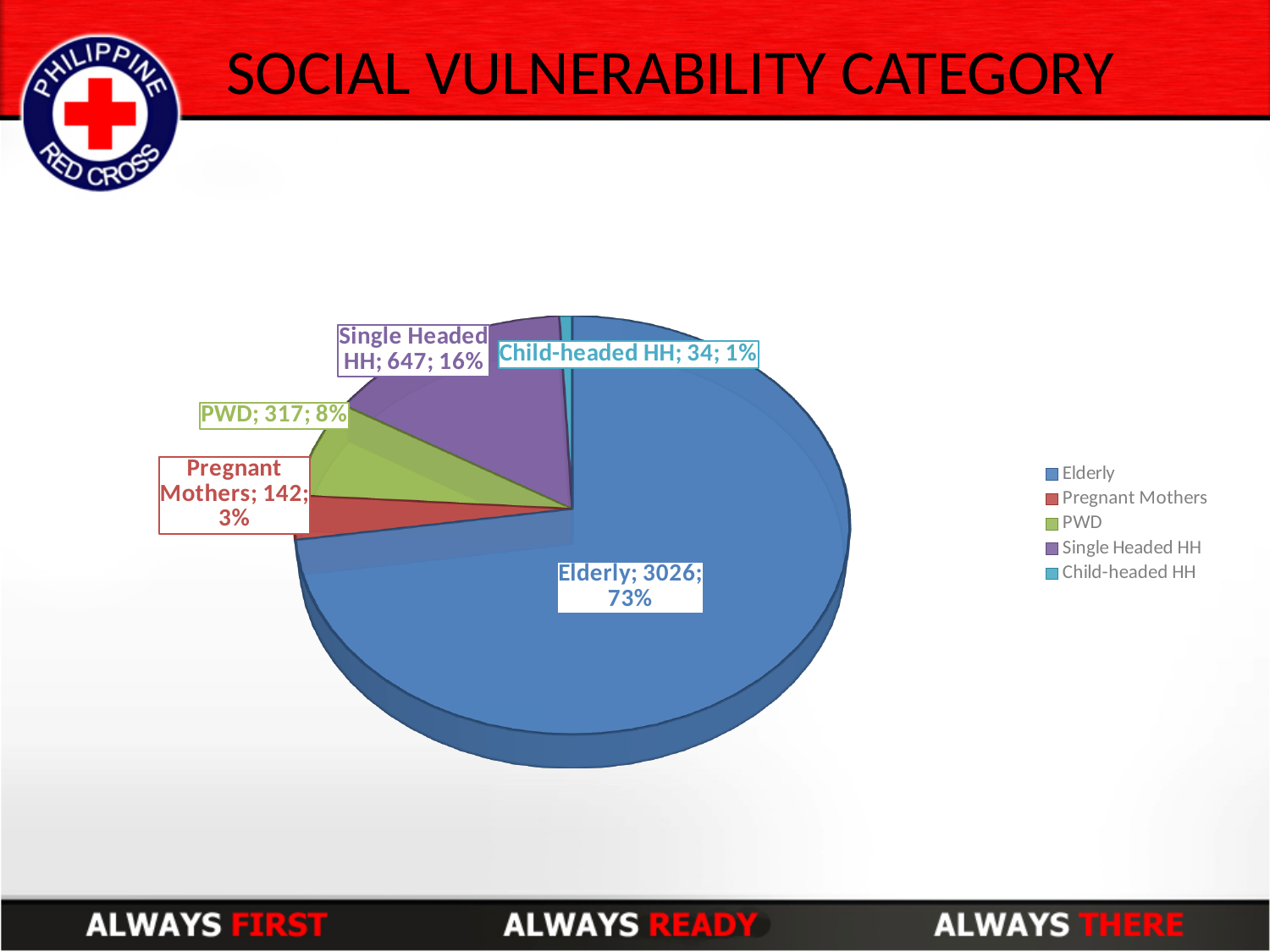
What share of the pie does Single Headed HH represent? 16% What share of the pie does Pregnant Mothers represent? 3% What is the difference between the values for Single Headed HH and PWD? 330 What type of chart is shown on the slide? pie chart What is the value for Child-headed HH? 34 What is the value for Elderly? 3026 What is the value for PWD? 317 How many categories does the pie chart have? 5 Which category has the largest slice? Elderly What is the value for Single Headed HH? 647 Which is larger, the value for PWD or the value for Pregnant Mothers? PWD Which category has the smallest slice? Child-headed HH